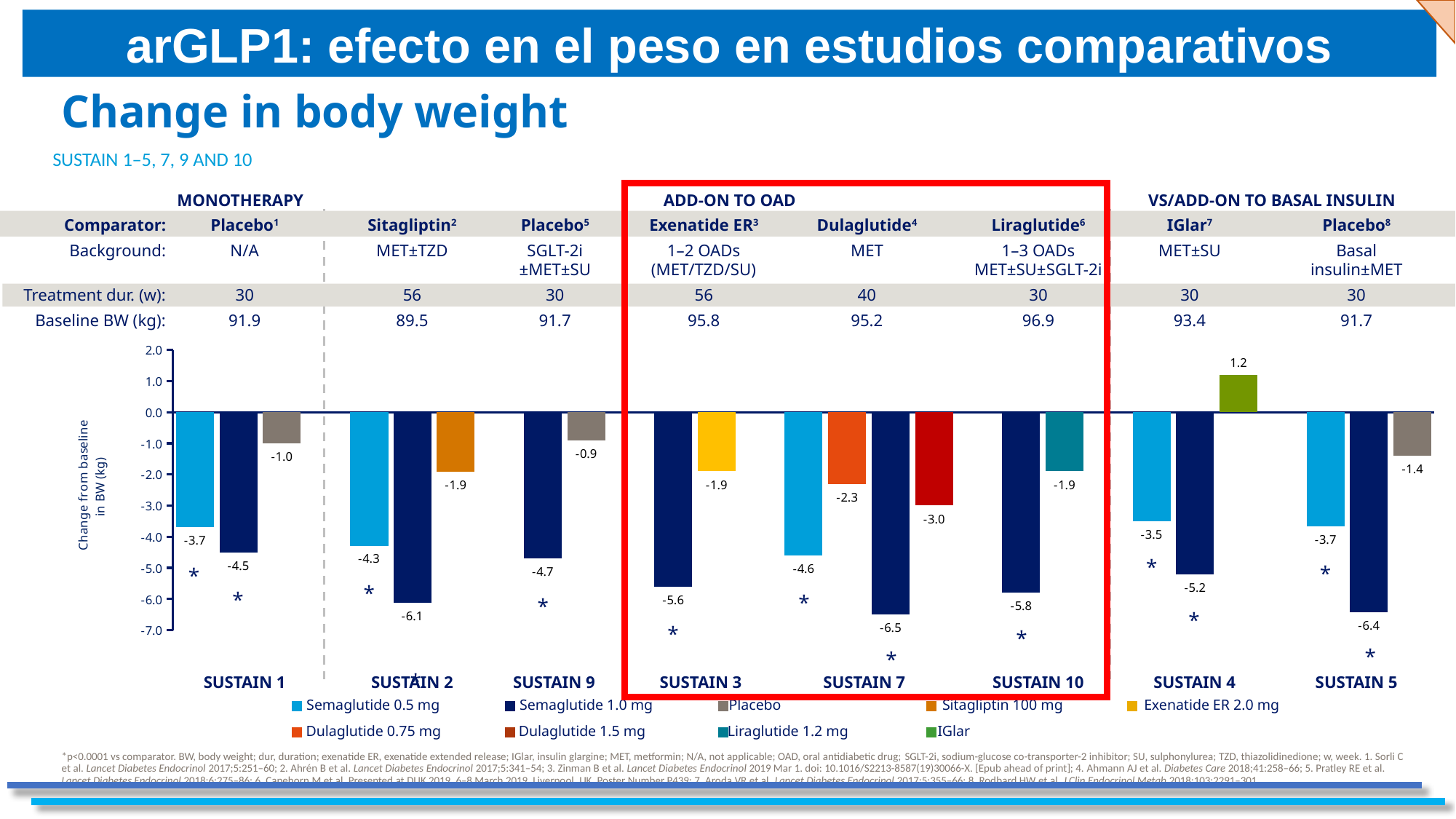
What is the change from baseline in body weight for Dulaglutide 1.5 mg in SUSTAIN 7? -3.0 What is the change from baseline in body weight for Semaglutide 1.0 mg in SUSTAIN 7? -6.5 What kind of chart is used to show the change in body weight? Bar chart Which bar shows the highest value on the chart? IGlar in SUSTAIN 4 What is the difference between the Semaglutide 1.0 mg and Placebo values in SUSTAIN 5? 5.0 In SUSTAIN 2, which has the larger weight reduction: Semaglutide 1.0 mg or Sitagliptin 100 mg? Semaglutide 1.0 mg How many series does the chart legend list? 9 What is the change from baseline in body weight for IGlar in SUSTAIN 4? 1.2 What is the label of the vertical axis of the chart? Change from baseline in BW (kg) What is the change from baseline in body weight for Placebo in SUSTAIN 1? -1.0 How many SUSTAIN trials are shown as categories on the x axis of the chart? 8 Which bar shows the largest reduction in body weight (the lowest value) on the chart? Semaglutide 1.0 mg in SUSTAIN 7